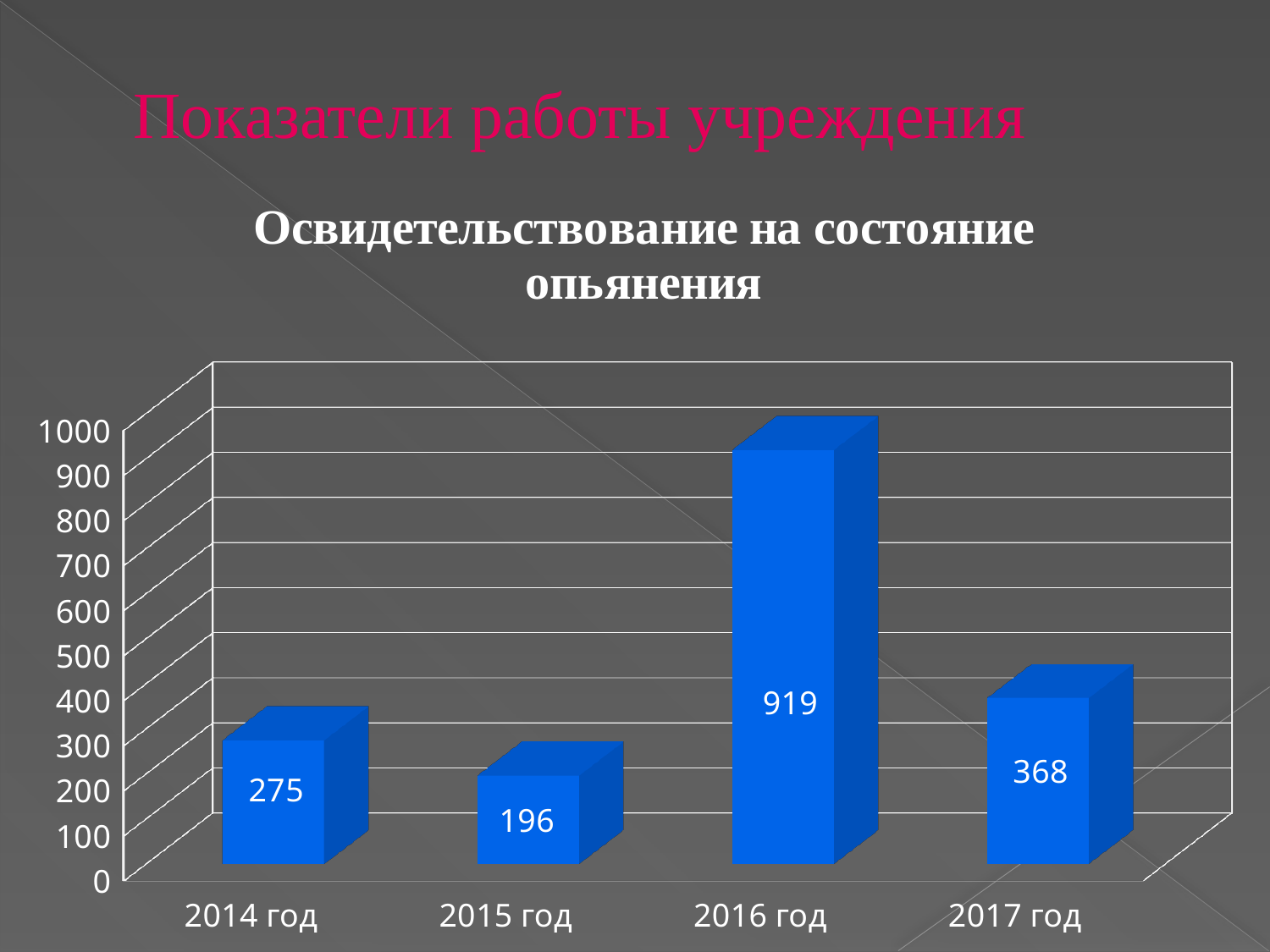
What is the value for 2017 год? 368 What is the value for 2014 год? 275 What is the value for 2015 год? 196 What is the difference between the values for 2016 год and 2017 год? 551 What is the difference between the values for 2014 год and 2015 год? 79 What is the value for 2016 год? 919 Which is larger, the value for 2014 год or the value for 2017 год? 2017 год What is the title of the chart? Освидетельствование на состояние опьянения How many years are shown on the chart? 4 What kind of chart is shown on the slide? Bar chart Which year has the highest value? 2016 год Which year has the lowest value? 2015 год